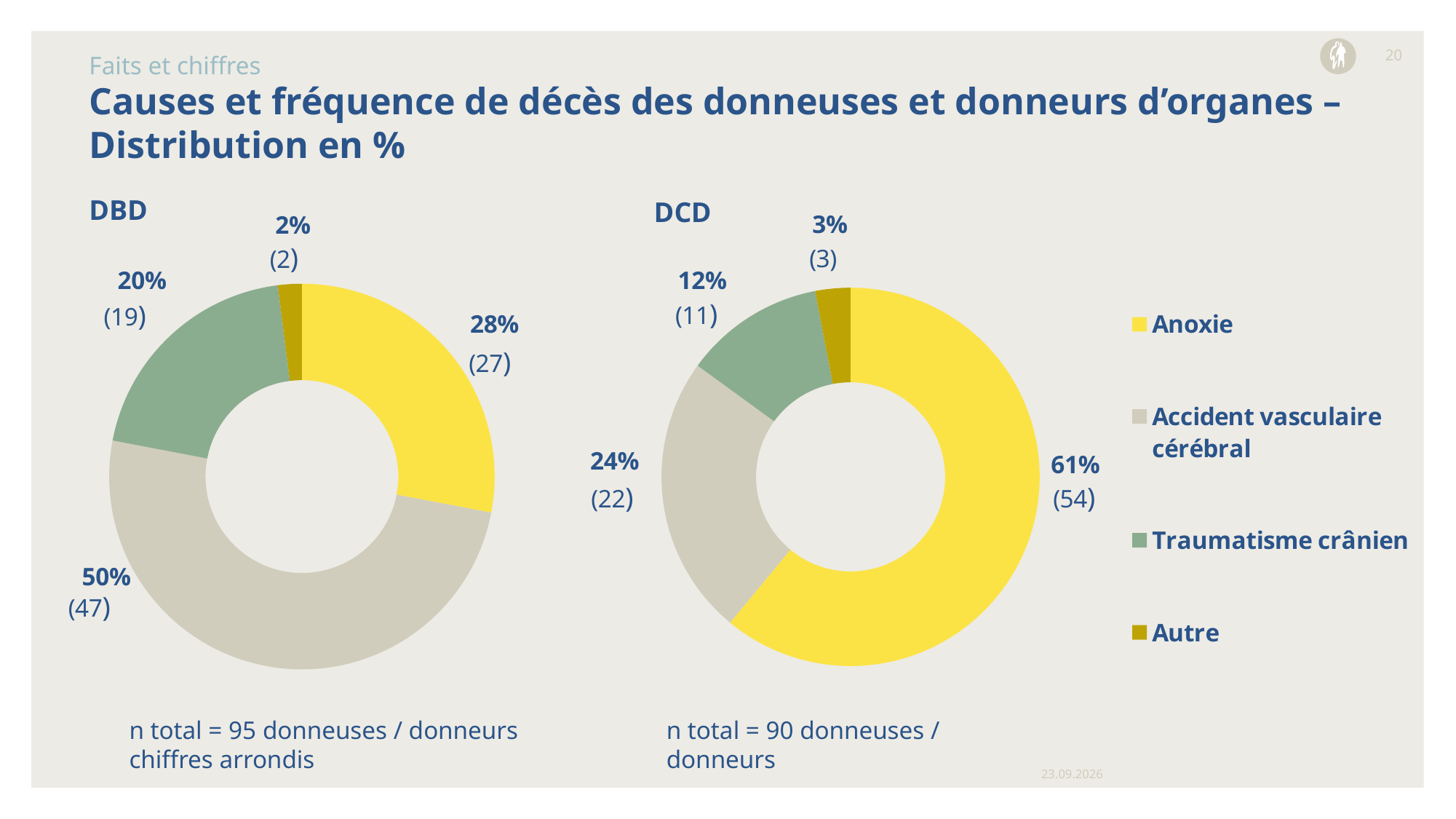
What is the total number of donors stated for the DBD chart? 95 How many categories does the legend list? 4 In the DBD chart, what percentage is shown for Accident vasculaire cérébral? 50% In the DCD chart, what percentage is shown for Autre? 3% In the DBD chart, which is larger: the share for Anoxie or the share for Traumatisme crânien? Anoxie In the DCD chart, what is the difference in percentage points between Anoxie and Accident vasculaire cérébral? 37 In the DCD chart, which category has the smallest share? Autre In the DBD chart, which category has the largest share? Accident vasculaire cérébral Which colour represents Traumatisme crânien in the legend? Green What kind of chart is used for DBD and DCD? Doughnut (pie) chart In the DBD chart, how many donors are shown in parentheses for Traumatisme crânien? 19 In the DCD chart, what percentage is shown for Anoxie? 61%